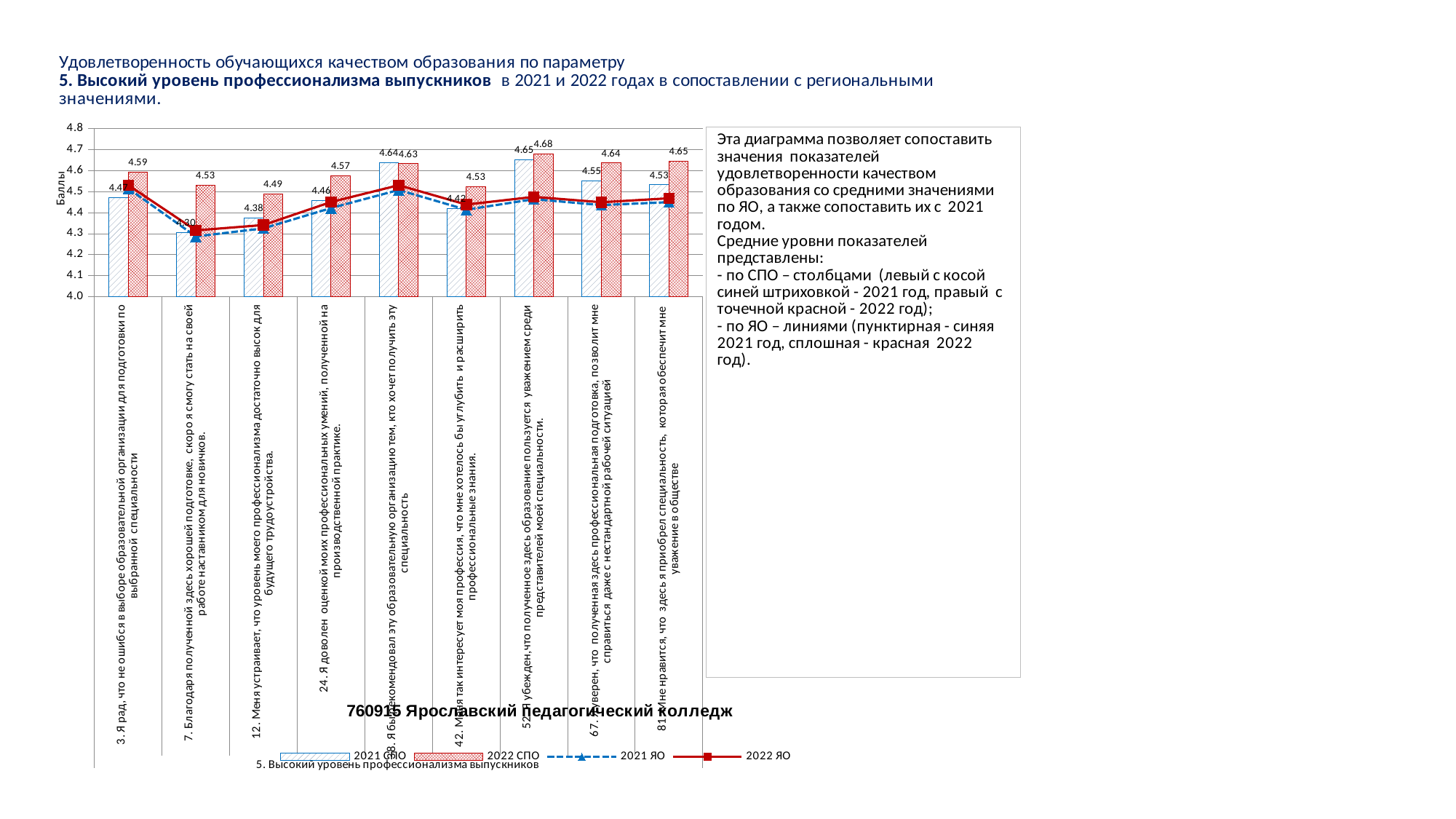
What is the difference between the 2022 СПО and 2021 СПО values for statement 81 ("Мне нравится, что здесь я приобрел специальность, которая обеспечит мне уважение в обществе")? 0.12 For which statement is the 2022 СПО bar the lowest? 12. Меня устраивает, что уровень моего профессионализма достаточно высок для будущего трудоустройства For statement 67 ("Уверен, что полученная здесь профессиональная подготовка, позволит мне справиться даже с нестандартной рабочей ситуацией"), which is larger: the 2021 СПО value or the 2022 СПО value? 2022 СПО What type of chart is shown on the slide? Combined bar and line chart For which statement is the 2022 СПО bar the highest? 52. Я убежден, что полученное здесь образование пользуется уважением среди представителей моей специальности How many statements (categories) are shown on the x axis of the chart? 9 How many series does the chart legend list? 4 What is the value of the 2022 СПО bar for statement 52 ("Я убежден, что полученное здесь образование пользуется уважением среди представителей моей специальности")? 4.68 What is the value of the 2022 СПО bar for statement 24 ("Я доволен оценкой моих профессиональных умений, полученной на производственной практике")? 4.57 What is the value of the 2021 СПО bar for statement 12 ("Меня устраивает, что уровень моего профессионализма достаточно высок для будущего трудоустройства")? 4.38 Is the 2022 ЯО line value for statement 7 ("Благодаря полученной здесь хорошей подготовке...") greater or less than 4.4? less For which statement is the 2021 СПО bar the lowest? 7. Благодаря полученной здесь хорошей подготовке, скоро я смогу стать наставником для новичков